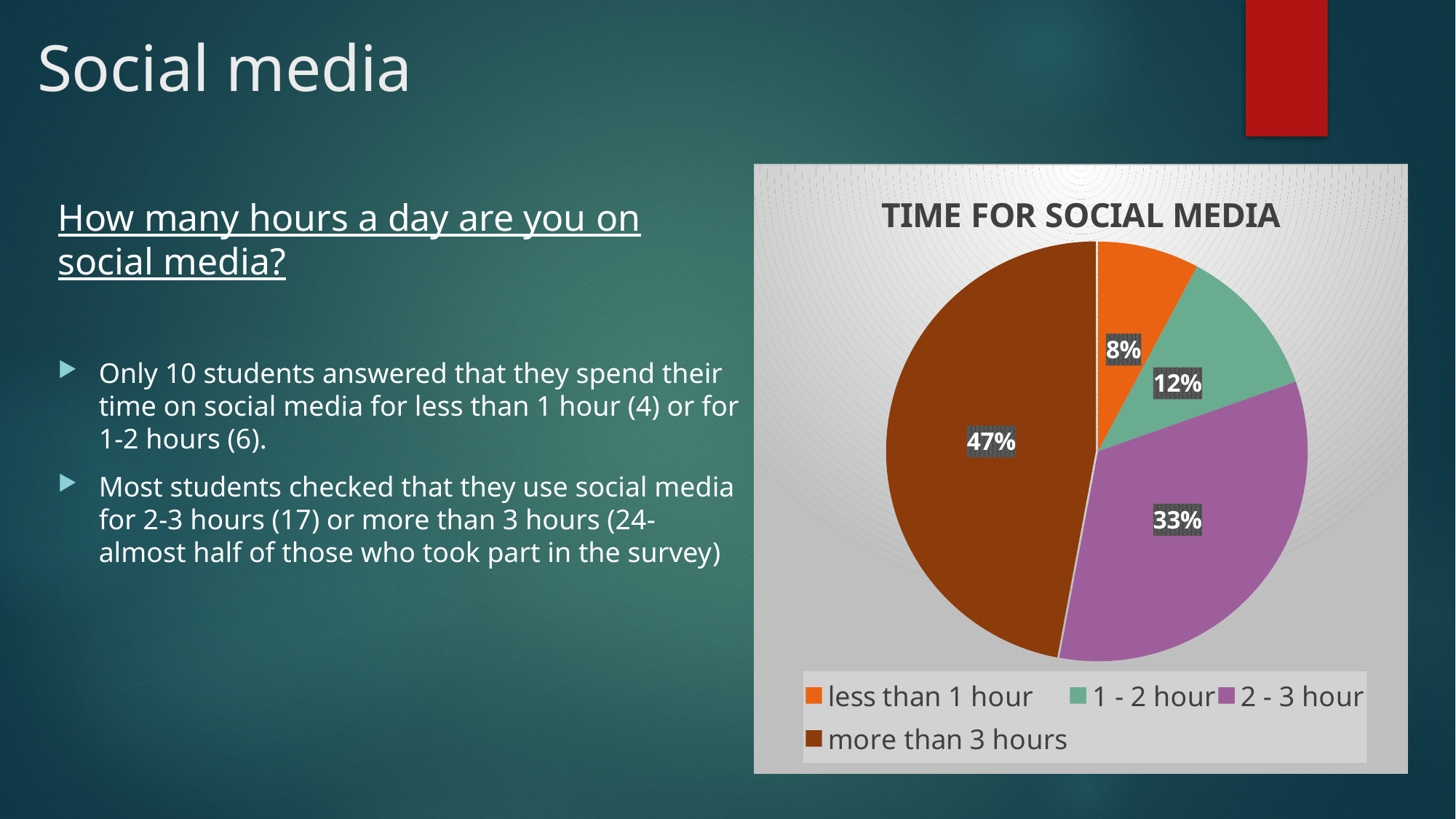
Which category has the largest slice of the pie? more than 3 hours What share of the pie is labelled for '1 - 2 hour'? 12% What is the title of the chart? TIME FOR SOCIAL MEDIA What is the difference in percentage points between 'more than 3 hours' and '2 - 3 hour'? 14% What share of the pie is labelled for 'more than 3 hours'? 47% What colour is the slice for '2 - 3 hour'? purple Which category has the smallest slice of the pie? less than 1 hour What share of the pie is labelled for '2 - 3 hour'? 33% How many categories does the pie chart show? 4 What type of chart is shown on the slide? pie chart Which slice is larger: '1 - 2 hour' or 'less than 1 hour'? 1 - 2 hour